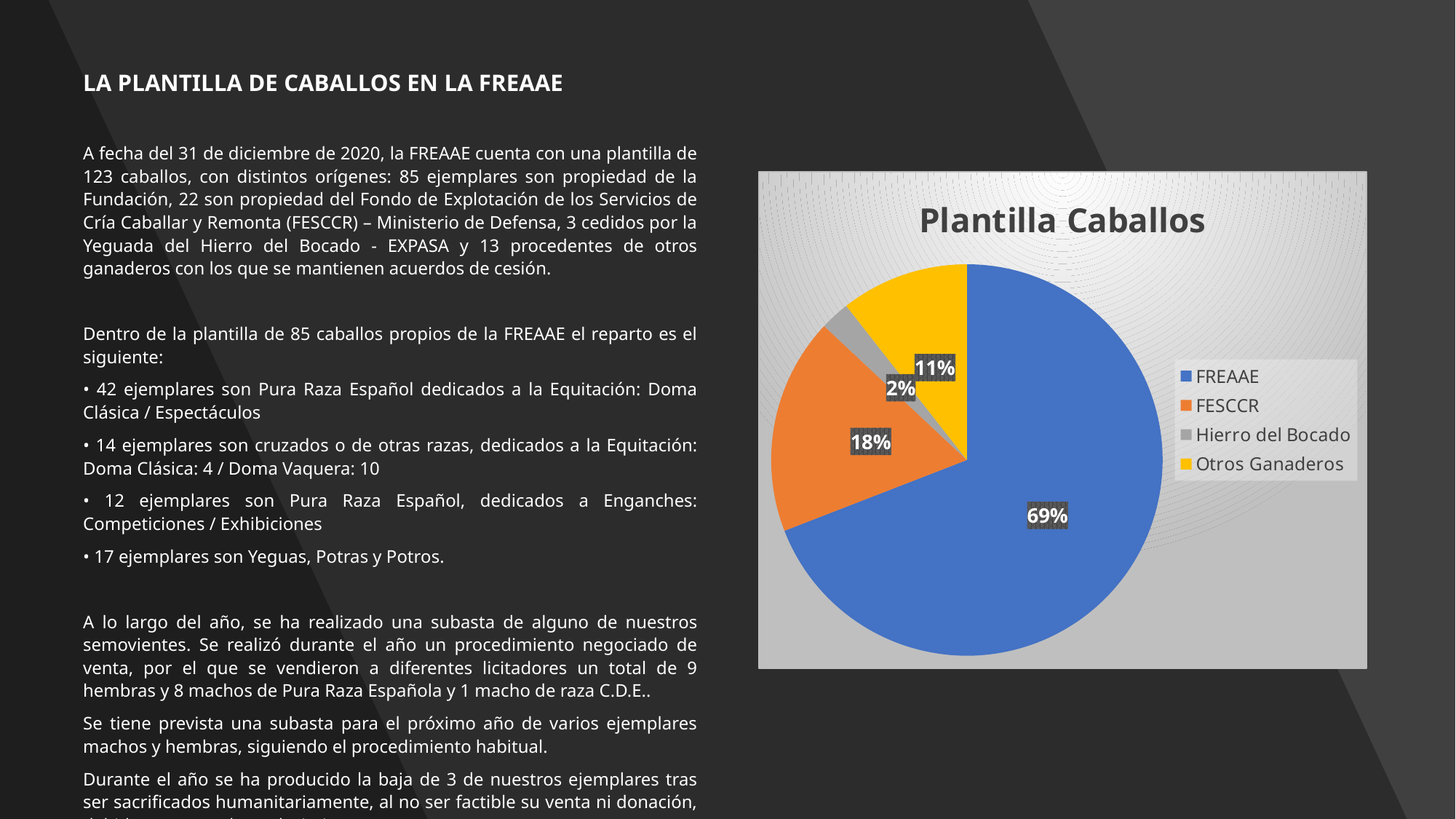
What kind of chart is shown on the slide? Pie chart What share of the pie does FESCCR hold? 18% What share of the pie does FREAAE hold? 69% What share of the pie does Hierro del Bocado hold? 2% What colour is the FESCCR slice in the pie chart? Orange Which category has the largest slice of the pie? FREAAE Which slice is larger, FESCCR or Otros Ganaderos? FESCCR What is the title of the chart? Plantilla Caballos What is the difference in percentage points between the FREAAE slice and the FESCCR slice? 51 How many categories does the pie chart show? 4 Which category has the smallest slice of the pie? Hierro del Bocado